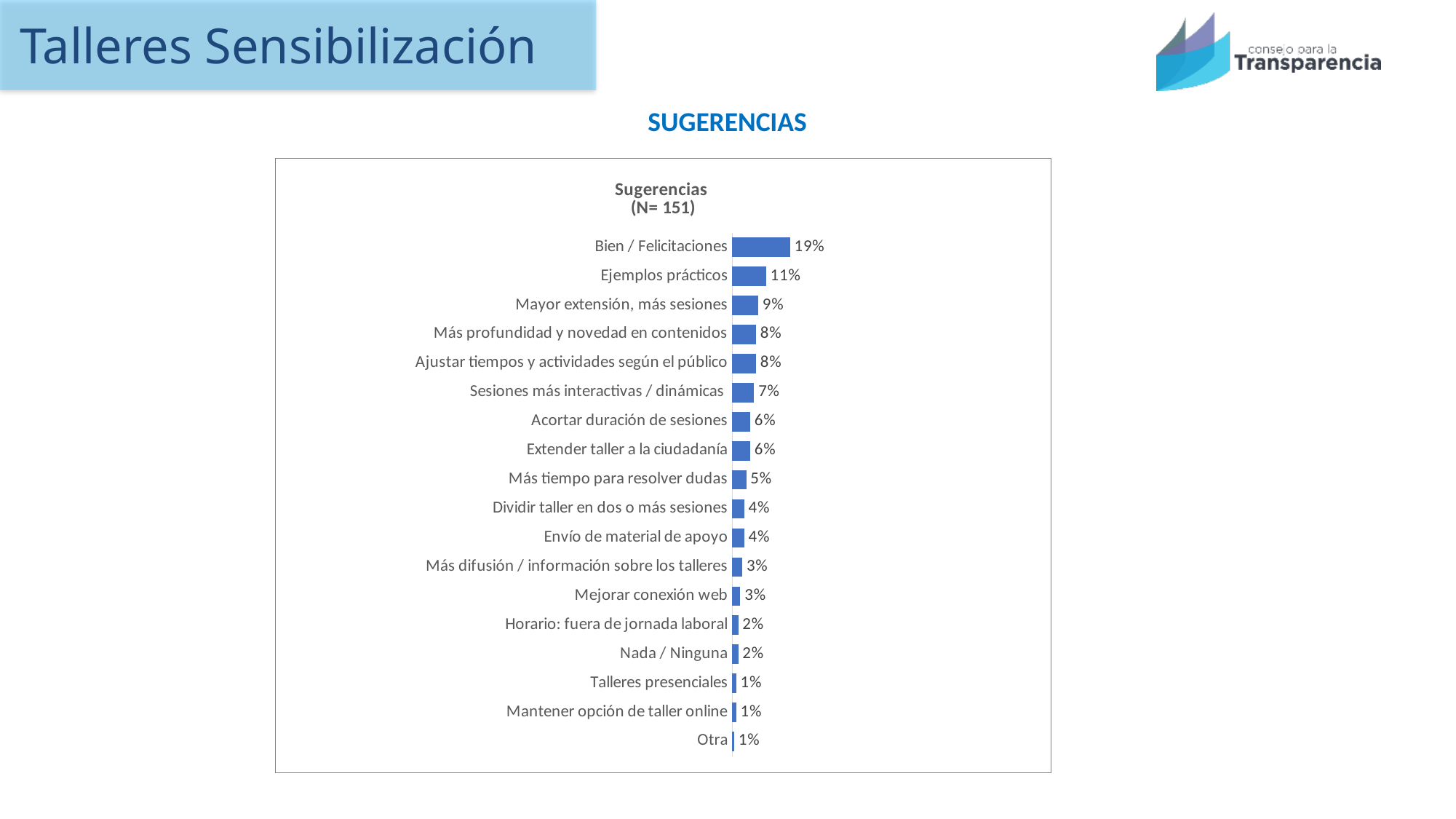
What sample size (N) is stated in the chart title? 151 What is the value for "Ejemplos prácticos"? 11% What is the value for "Mejorar conexión web"? 3% How many categories are shown in the chart? 18 What is the difference between the values for "Bien / Felicitaciones" and "Ejemplos prácticos"? 8% Which category has the highest value? Bien / Felicitaciones Which is larger, the value for "Acortar duración de sesiones" or the value for "Dividir taller en dos o más sesiones"? Acortar duración de sesiones What is the difference between the values for "Mayor extensión, más sesiones" and "Más tiempo para resolver dudas"? 4% What is the value for "Nada / Ninguna"? 2% What type of chart is shown on the slide? bar chart What is the value for "Sesiones más interactivas / dinámicas"? 7% What is the value for "Bien / Felicitaciones"? 19%